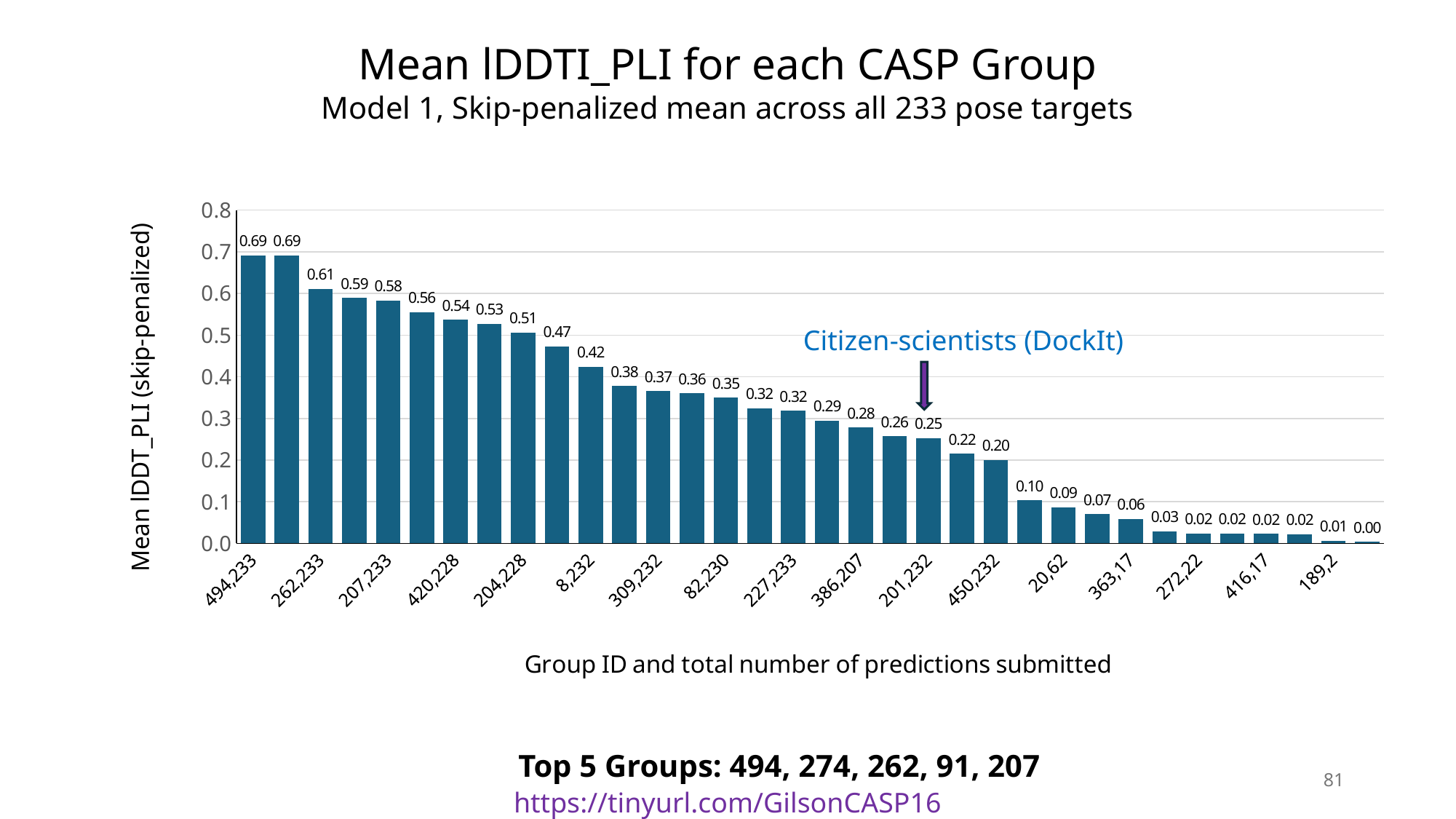
What is the difference between the mean lDDT_PLI values for groups 494,233 and 201,232? 0.44 What kind of chart is shown on the slide? bar chart What is the mean lDDT_PLI value for group 8,232? 0.42 What is the lowest mean lDDT_PLI value shown on the chart? 0.00 How many bars are plotted on the chart? 34 Which group has the larger mean lDDT_PLI, 207,233 or 420,228? 207,233 What is the highest mean lDDT_PLI value shown on the chart? 0.69 What is the mean lDDT_PLI value for group 20,62? 0.09 What is the mean lDDT_PLI value for group 494,233? 0.69 Is the mean lDDT_PLI value for group 309,232 greater or less than 0.4? less Do the mean lDDT_PLI values rise or fall from left to right along the x axis? fall What is the mean lDDT_PLI value for group 201,232? 0.25